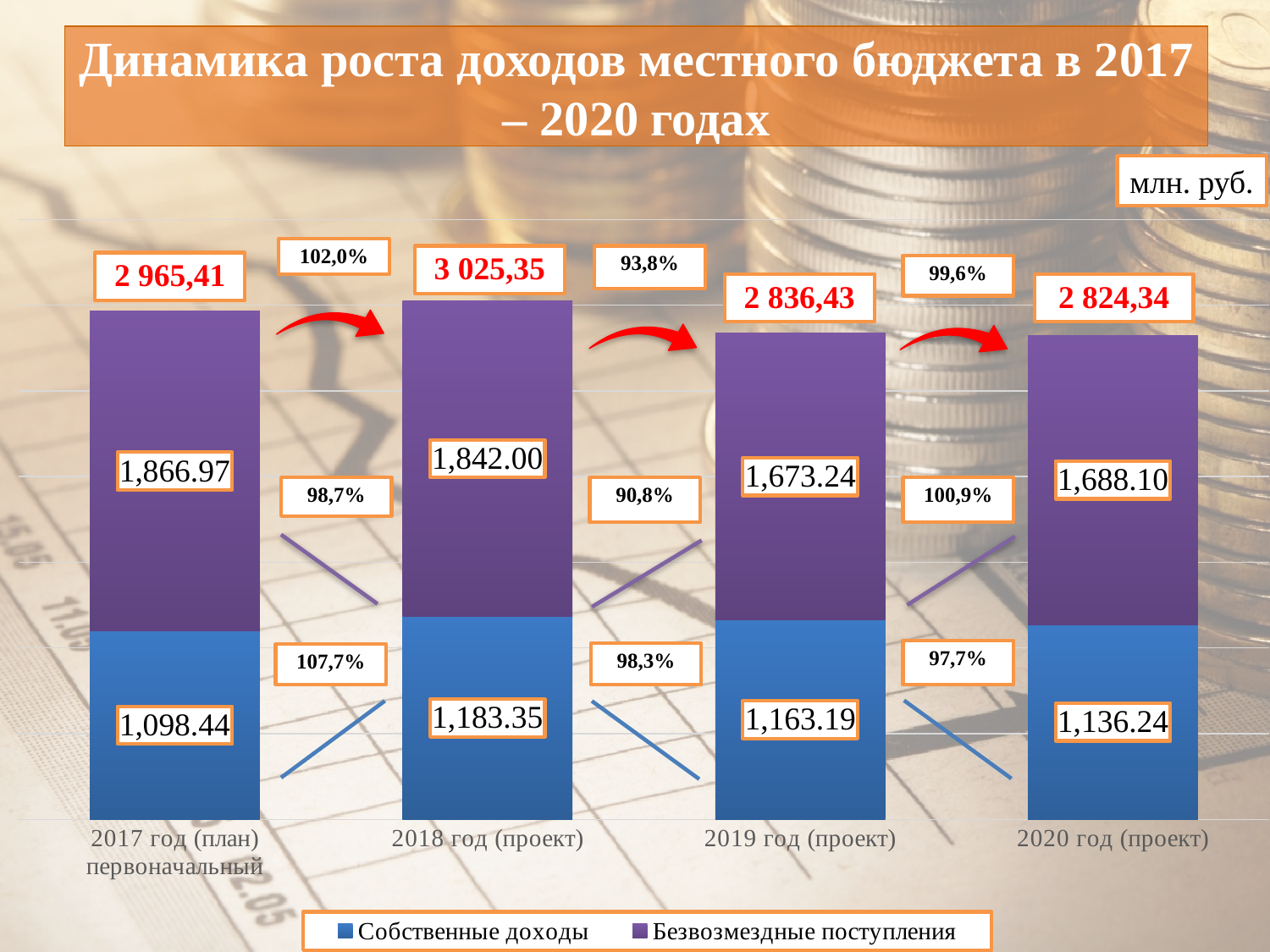
Which is larger: Собственные доходы in 2019 год (проект) or in 2020 год (проект)? 2019 год (проект) How many year categories are shown on the x axis? 4 What is the value of Безвозмездные поступления for 2020 год (проект)? 1,688.10 What is the value of Собственные доходы for 2017 год (план) первоначальный? 1,098.44 What is the value of Собственные доходы for 2018 год (проект)? 1,183.35 How many series does the legend list? 2 Which year has the highest value of Безвозмездные поступления? 2017 год (план) первоначальный What is the total shown above the bar for 2018 год (проект)? 3 025,35 What type of chart is shown on the slide? Stacked bar chart What unit of measurement is indicated on the slide for the chart values? млн. руб. What is the value of Безвозмездные поступления for 2019 год (проект)? 1,673.24 Which year has the lowest value of Собственные доходы? 2017 год (план) первоначальный